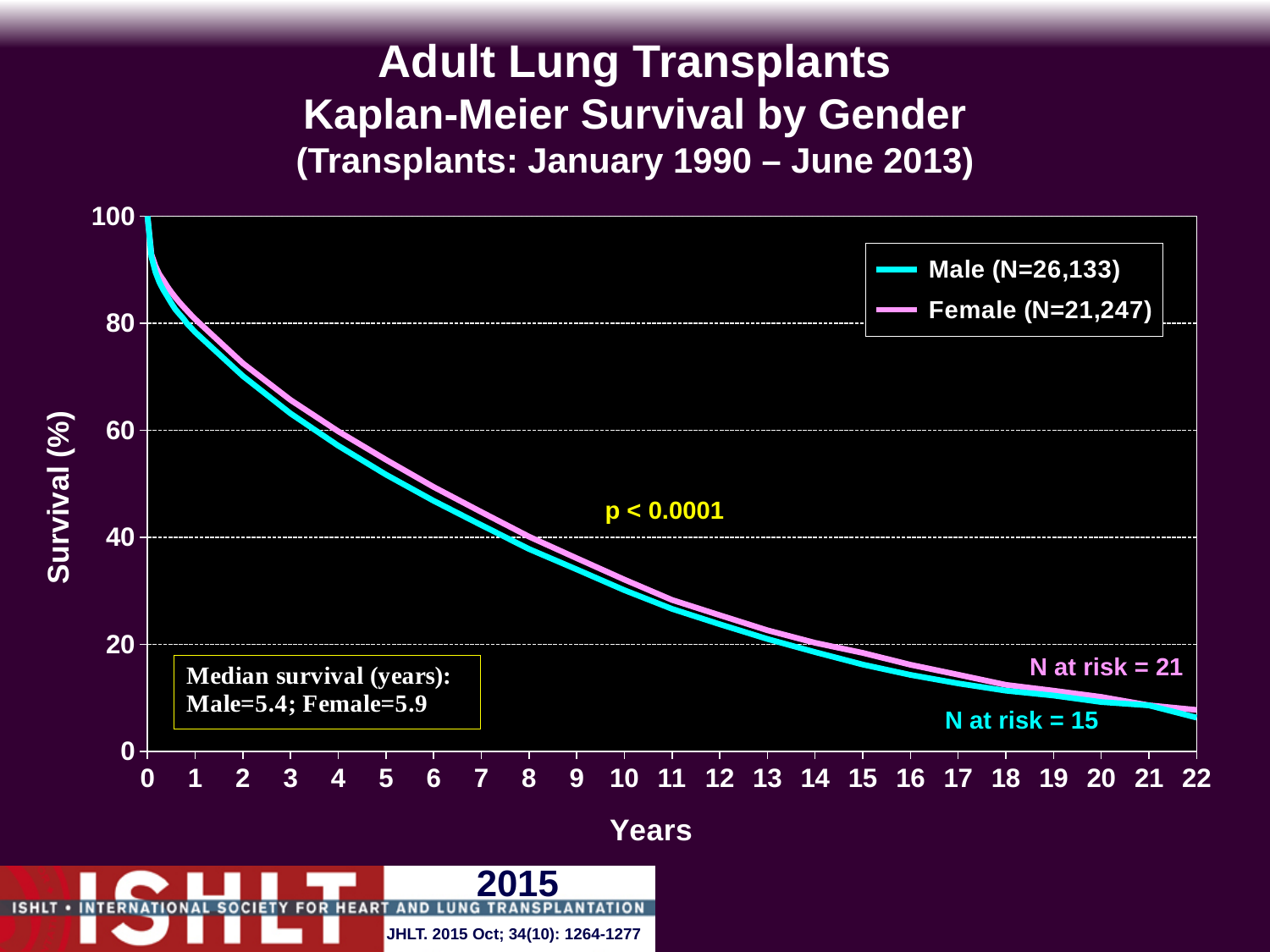
What p-value is shown on the chart? p < 0.0001 What is the difference in median survival (years) between females and males? 0.5 Do the survival curves rise or fall as years increase? fall What is the median survival in years for females? 5.9 Which gender has the higher median survival? Female What is the N for the Female series shown in the legend? 21,247 Is the survival value for the Female curve at 10 years greater or less than 40? less Is the survival value for the Male curve at 2 years greater or less than 60? greater How many series does the legend list? 2 What is the N for the Male series shown in the legend? 26,133 What is the median survival in years for males? 5.4 What kind of chart is shown on the slide? line chart